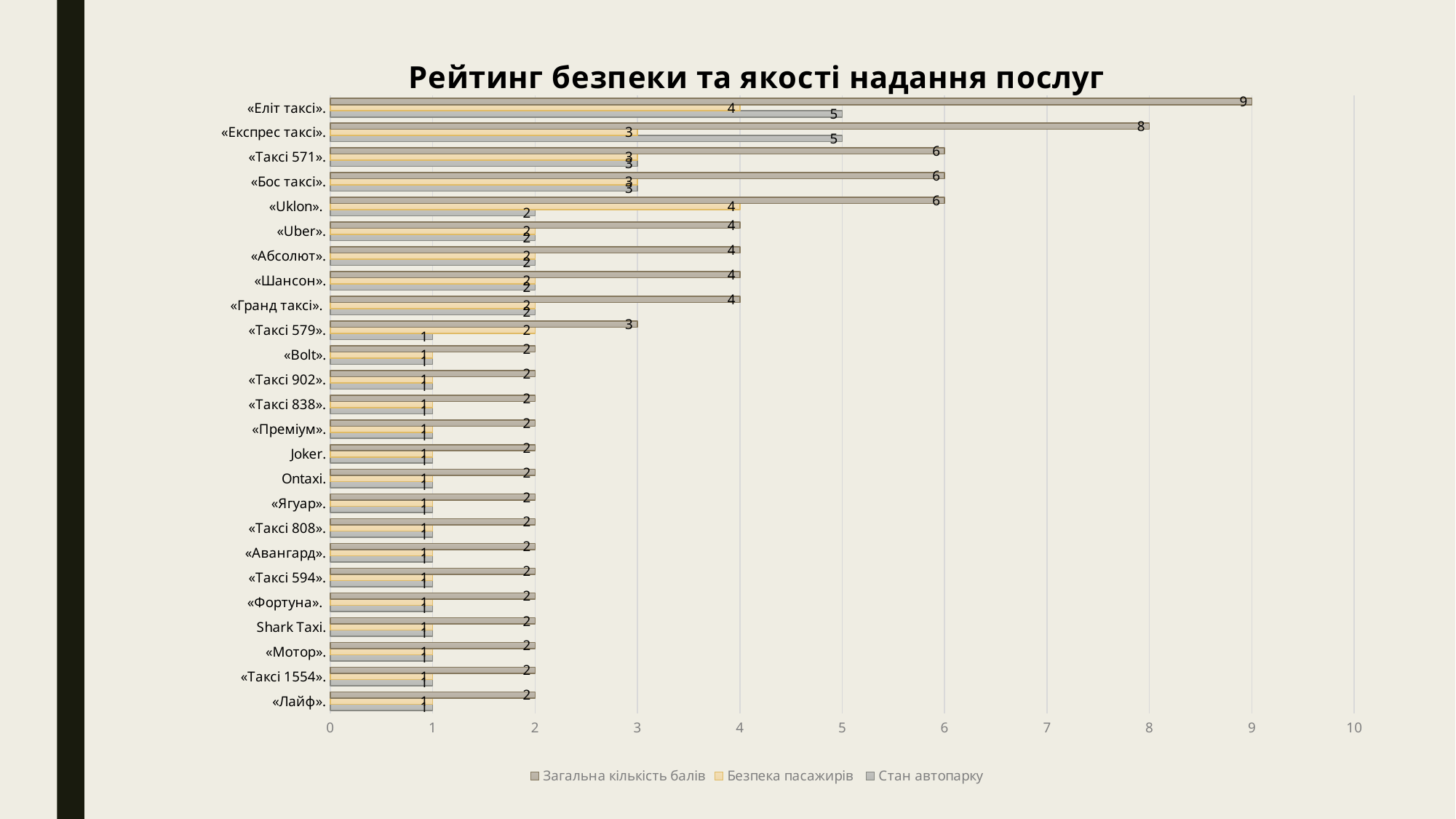
Which category has the highest value of «Загальна кількість балів»? «Еліт таксі» How many categories (taxi services) are shown on the chart? 25 What is the difference between «Загальна кількість балів» for «Еліт таксі» and for «Експрес таксі»? 1 Is the value of «Загальна кількість балів» for «Експрес таксі» greater or less than 5? greater What is the value of «Загальна кількість балів» for «Таксі 579»? 3 Which is larger: «Безпека пасажирів» for «Uklon» or for «Таксі 571»? «Uklon» What is the value of «Загальна кількість балів» for «Еліт таксі»? 9 What is the value of «Стан автопарку» for «Uklon»? 2 What is the value of «Безпека пасажирів» for «Експрес таксі»? 3 How many series does the legend list? 3 What kind of chart is shown on the slide? bar chart What is the title of the chart? Рейтинг безпеки та якості надання послуг